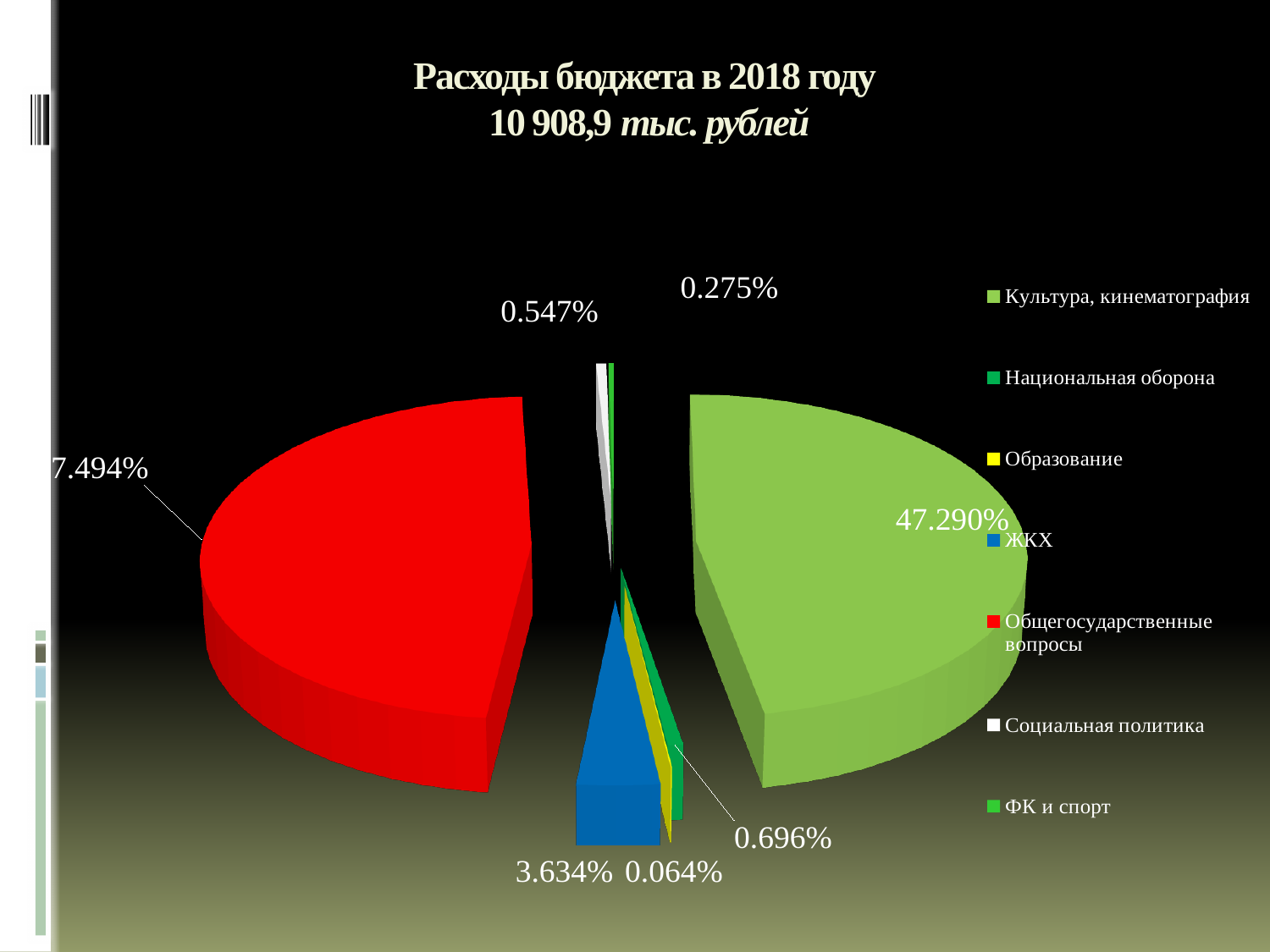
What is the value shown for Национальная оборона? 0.696% What is the difference between the values for ЖКХ and Образование? 3.570% Which category has the smallest slice of the pie? Образование How many categories does the legend of the pie chart list? 7 What is the value shown for ЖКХ? 3.634% What share of the pie does Культура, кинематография have? 47.290% What kind of chart is shown on the slide? pie chart What is the value shown for ФК и спорт? 0.275% Which is larger, the slice for ЖКХ or the slice for Национальная оборона? ЖКХ What is the value shown for Социальная политика? 0.547% What is the value shown for Образование? 0.064% What total budget expenditure amount is stated in the chart title? 10 908,9 тыс. рублей